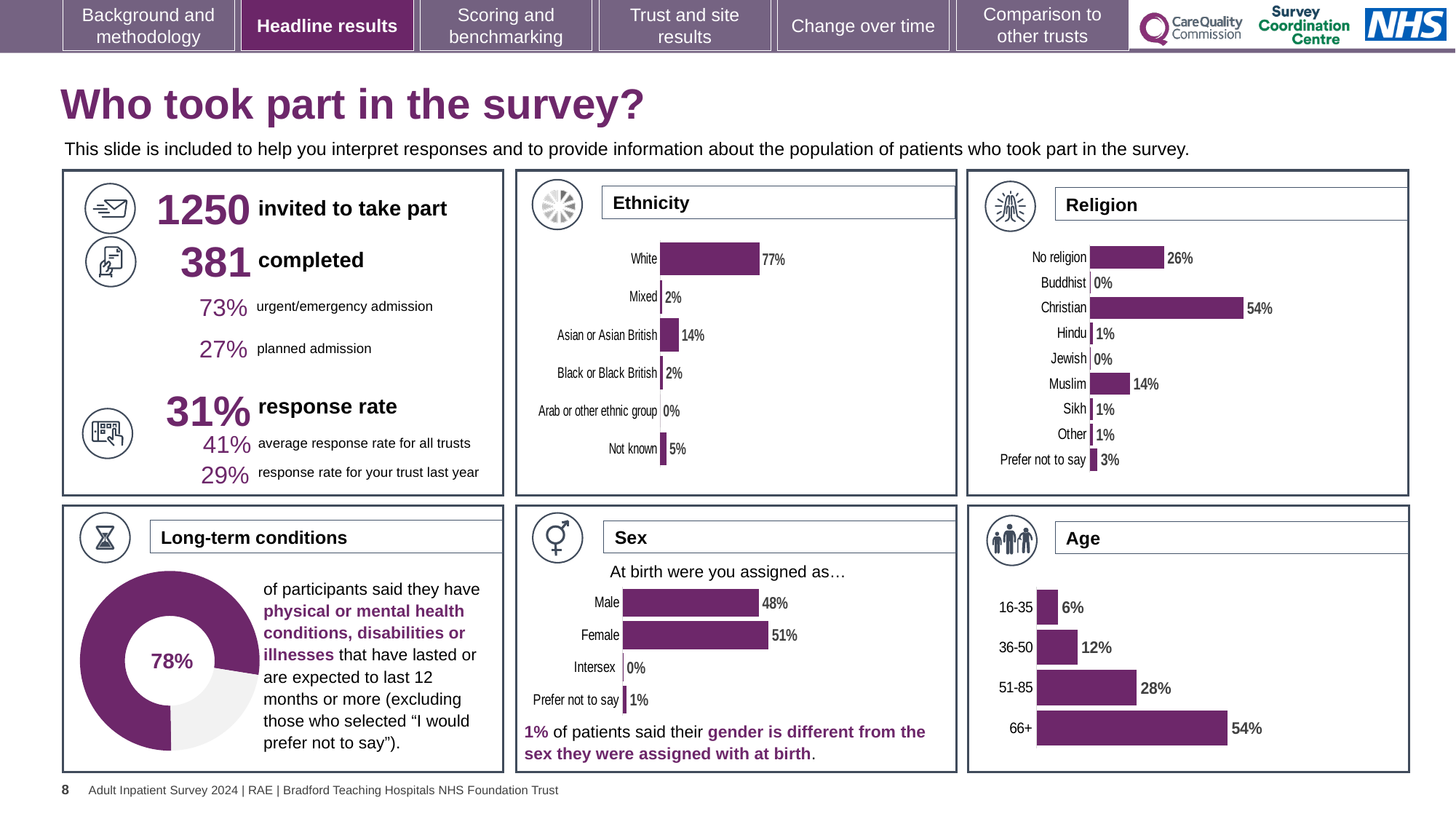
In the Ethnicity chart, how many categories are shown? 6 In the Age chart, which age group has the lowest value? 16-35 In the Religion chart, what is the value for Muslim? 14% In the Age chart, do the values rise or fall as age increases from 16-35 to 66+? rise In the Age chart, what is the difference between 66+ and 51-85? 26% In the Sex chart, which is larger, Male or Female? Female In the Religion chart, what is the difference between Christian and No religion? 28% In the Religion chart, how many categories are shown? 9 In the Sex chart, what is the value for Prefer not to say? 1% In the Ethnicity chart, which category has the highest value? White In the Ethnicity chart, what percentage of respondents were White? 77% What kind of chart is used in the Long-term conditions panel? Doughnut chart